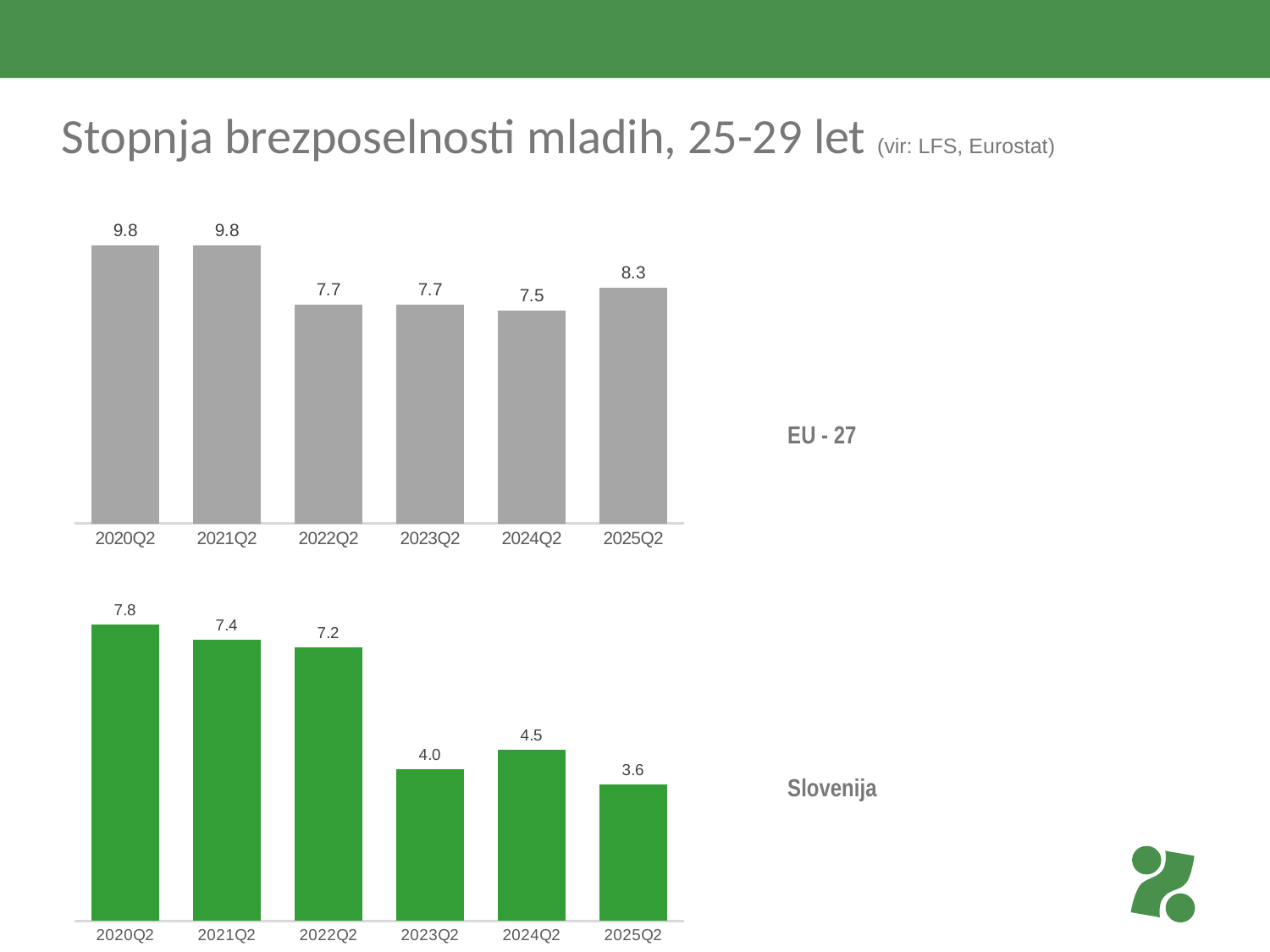
In the EU - 27 chart, which period has the lowest value? 2024Q2 In the Slovenija chart, what is the difference between the 2022Q2 value and the 2023Q2 value? 3.2 In the EU - 27 chart, what is the value for 2025Q2? 8.3 What kind of chart is the Slovenija chart? Bar chart In the EU - 27 chart, what is the difference between the 2020Q2 value and the 2024Q2 value? 2.3 In the Slovenija chart, which period has the highest value? 2020Q2 In the Slovenija chart, which is larger, the value for 2024Q2 or the value for 2025Q2? 2024Q2 In the Slovenija chart, which period has the lowest value? 2025Q2 How many periods are shown on the x axis of the EU - 27 chart? 6 In the Slovenija chart, do the values generally rise or fall from 2020Q2 to 2025Q2? Fall What colour are the bars in the EU - 27 chart? Grey In the Slovenija chart, what is the value for 2023Q2? 4.0